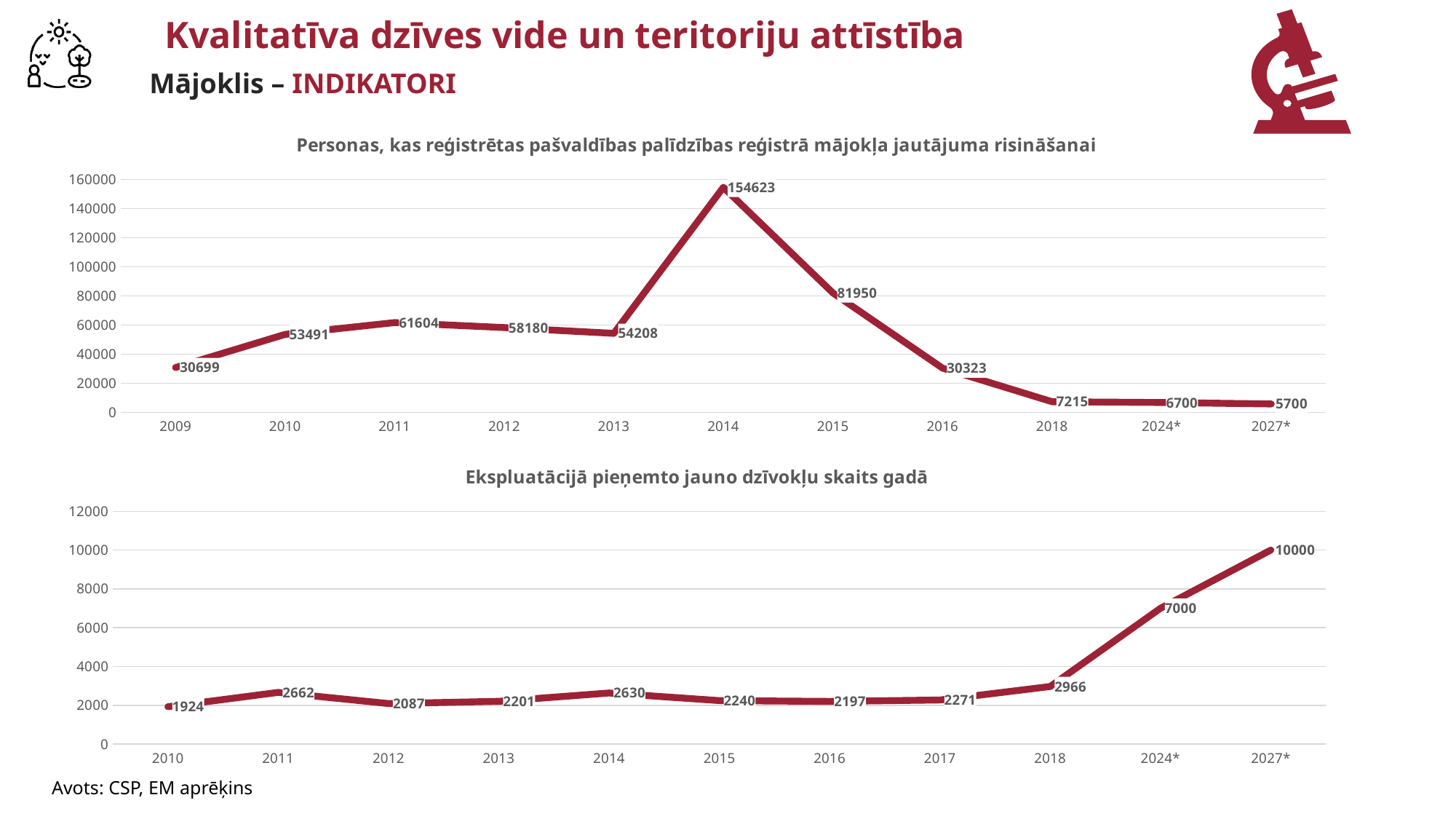
In the top chart (Personas, kas reģistrētas pašvaldības palīdzības reģistrā), which year has the lowest value? 2027* In the bottom chart (Ekspluatācijā pieņemto jauno dzīvokļu skaits gadā), which is larger, the value for 2011 or the value for 2014? 2011 In the top chart (Personas, kas reģistrētas pašvaldības palīdzības reģistrā), what is the value for 2014? 154623 In the top chart (Personas, kas reģistrētas pašvaldības palīdzības reģistrā), how many data points are plotted? 11 In the top chart (Personas, kas reģistrētas pašvaldības palīdzības reģistrā), what is the difference between the values for 2014 and 2015? 72673 What type of chart is the bottom chart (Ekspluatācijā pieņemto jauno dzīvokļu skaits gadā)? line chart In the bottom chart (Ekspluatācijā pieņemto jauno dzīvokļu skaits gadā), what is the difference between the values for 2027* and 2024*? 3000 In the bottom chart (Ekspluatācijā pieņemto jauno dzīvokļu skaits gadā), what is the value for 2018? 2966 In the top chart (Personas, kas reģistrētas pašvaldības palīdzības reģistrā), is the value for 2015 greater or less than 80000? greater In the top chart (Personas, kas reģistrētas pašvaldības palīdzības reģistrā), which year has the highest value? 2014 In the bottom chart (Ekspluatācijā pieņemto jauno dzīvokļu skaits gadā), do the values rise or fall from 2018 to 2027*? rise In the bottom chart (Ekspluatācijā pieņemto jauno dzīvokļu skaits gadā), which year has the lowest value? 2010